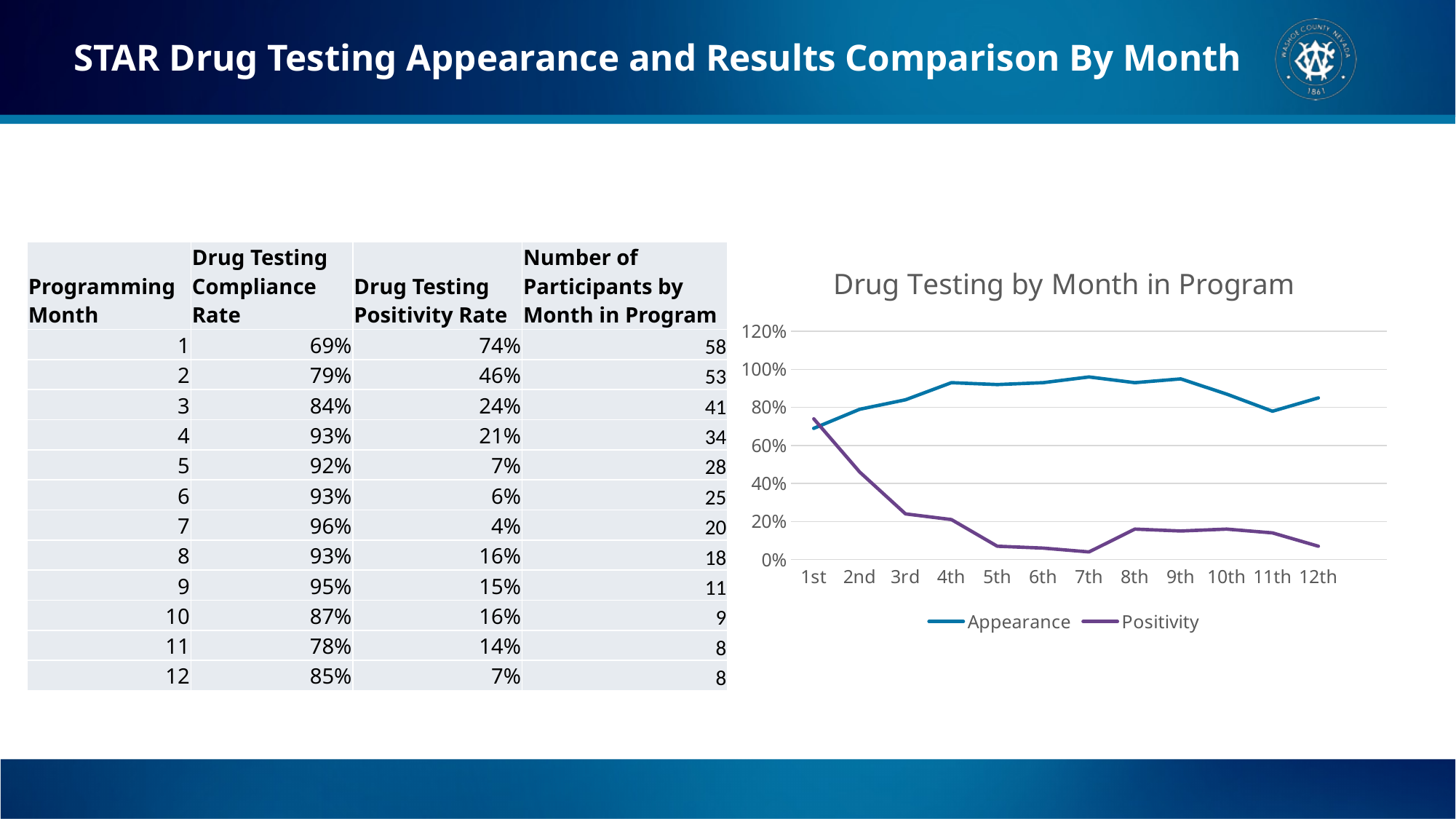
In the "Drug Testing by Month in Program" chart, is the Appearance value for the 7th month greater or less than 80%? greater In the "Drug Testing by Month in Program" chart, is the Positivity value for the 2nd month greater or less than 40%? greater In the "Drug Testing by Month in Program" chart, which month has the highest Positivity value? 1st What kind of chart is "Drug Testing by Month in Program"? line chart In the "Drug Testing by Month in Program" chart, which is larger: the Appearance value for the 4th month or for the 11th month? 4th month How many months are plotted along the x axis of the "Drug Testing by Month in Program" chart? 12 In the "Drug Testing by Month in Program" chart, is the Positivity value for the 7th month greater or less than 20%? less How many series does the legend of the "Drug Testing by Month in Program" chart list? 2 In the "Drug Testing by Month in Program" chart, does the Positivity line rise or fall from the 1st month to the 7th month? fall In the "Drug Testing by Month in Program" chart, which month has the lowest Appearance value? 1st What are the two legend entries in the "Drug Testing by Month in Program" chart? Appearance and Positivity